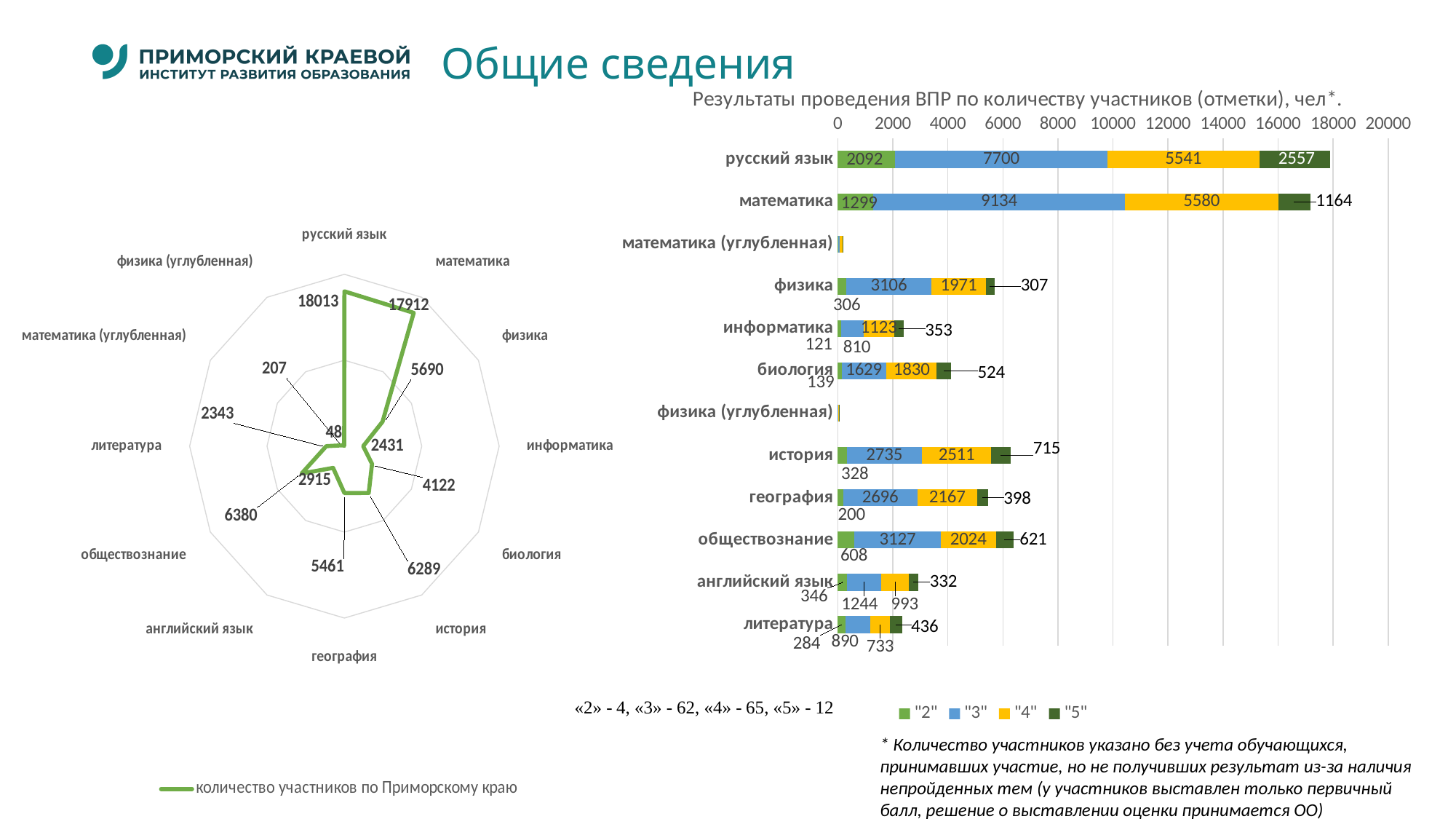
In the bar chart 'Результаты проведения ВПР по количеству участников (отметки), чел*.', how many participants received a "5" in история? 715 In the bar chart 'Результаты проведения ВПР по количеству участников (отметки), чел*.', how many participants received a "3" in математика? 9134 In the radar chart on the left, which subject has the lowest number of participants? физика (углубленная) In the radar chart on the left, what is the difference between the participants for история and география? 828 In the bar chart 'Результаты проведения ВПР по количеству участников (отметки), чел*.', what is the difference between the number of "4" marks in математика and in русский язык? 39 In the radar chart on the left, what is the number of participants for русский язык? 18013 In the bar chart 'Результаты проведения ВПР по количеству участников (отметки), чел*.', what is the total of the stacked bar for русский язык? 17890 How many subjects are shown in the bar chart 'Результаты проведения ВПР по количеству участников (отметки), чел*.'? 12 In the bar chart 'Результаты проведения ВПР по количеству участников (отметки), чел*.', which subject has more "4" marks, биология or информатика? биология What kind of chart is 'Результаты проведения ВПР по количеству участников (отметки), чел*.'? bar chart In the radar chart on the left, which subject has the highest number of participants? русский язык How many series does the legend of the bar chart 'Результаты проведения ВПР по количеству участников (отметки), чел*.' list? 4